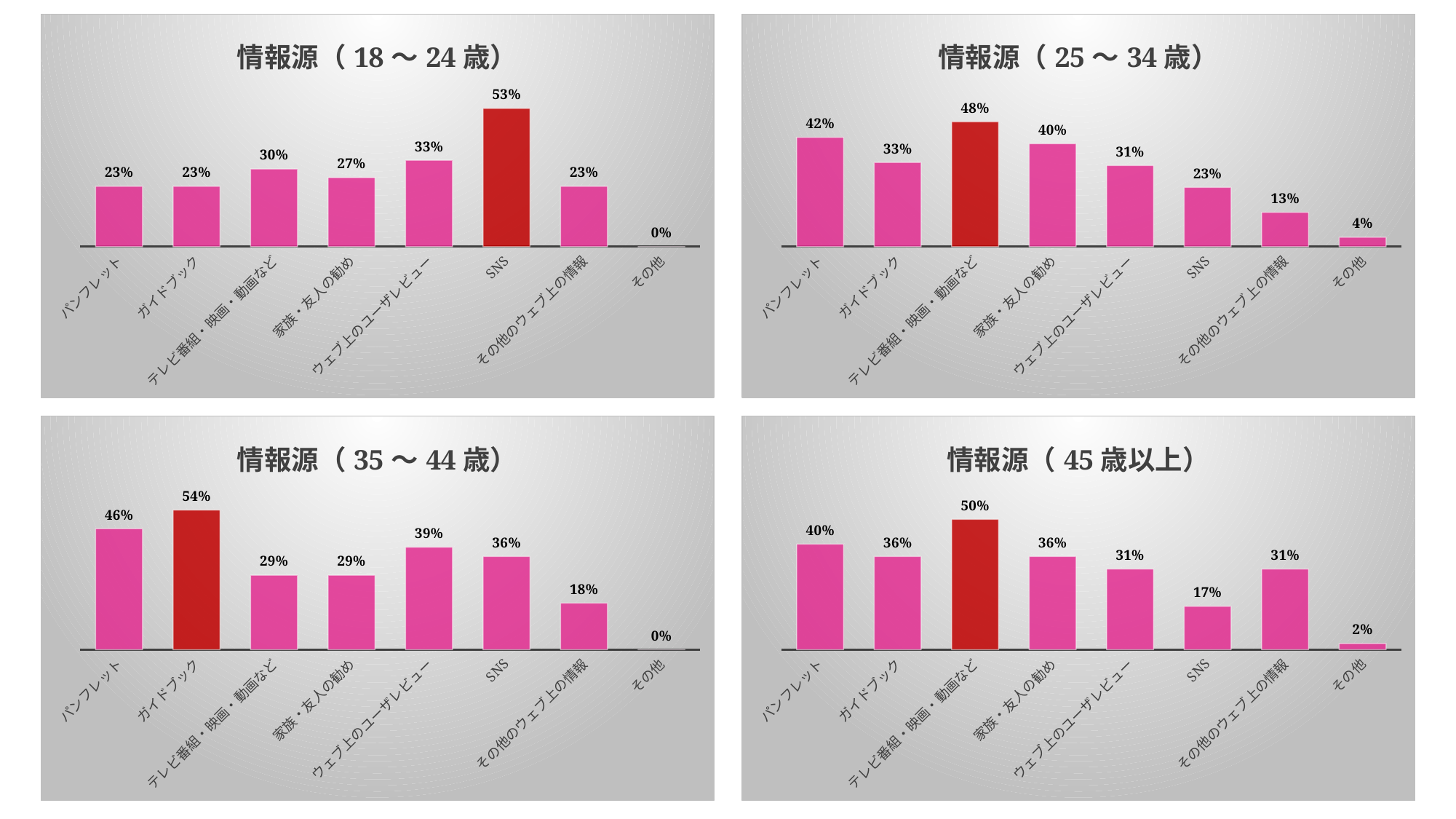
How many categories are shown in the 情報源（18～24歳） chart? 8 In the 情報源（25～34歳） chart, which category has the highest value? テレビ番組・映画・動画など In the 情報源（45歳以上） chart, which category has the lowest value? その他 In the 情報源（45歳以上） chart, which is larger, SNS or その他のウェブ上の情報? その他のウェブ上の情報 In the 情報源（25～34歳） chart, what is the difference between パンフレット and SNS? 19% In the 情報源（25～34歳） chart, what is the value for その他? 4% In the 情報源（18～24歳） chart, what is the difference between SNS and ウェブ上のユーザレビュー? 20% What kind of chart is the 情報源（35～44歳） chart? bar chart In the 情報源（18～24歳） chart, what is the value for SNS? 53% In the 情報源（35～44歳） chart, what is the value for ガイドブック? 54% How many charts are on the slide? 4 In the 情報源（35～44歳） chart, what is the value for その他のウェブ上の情報? 18%